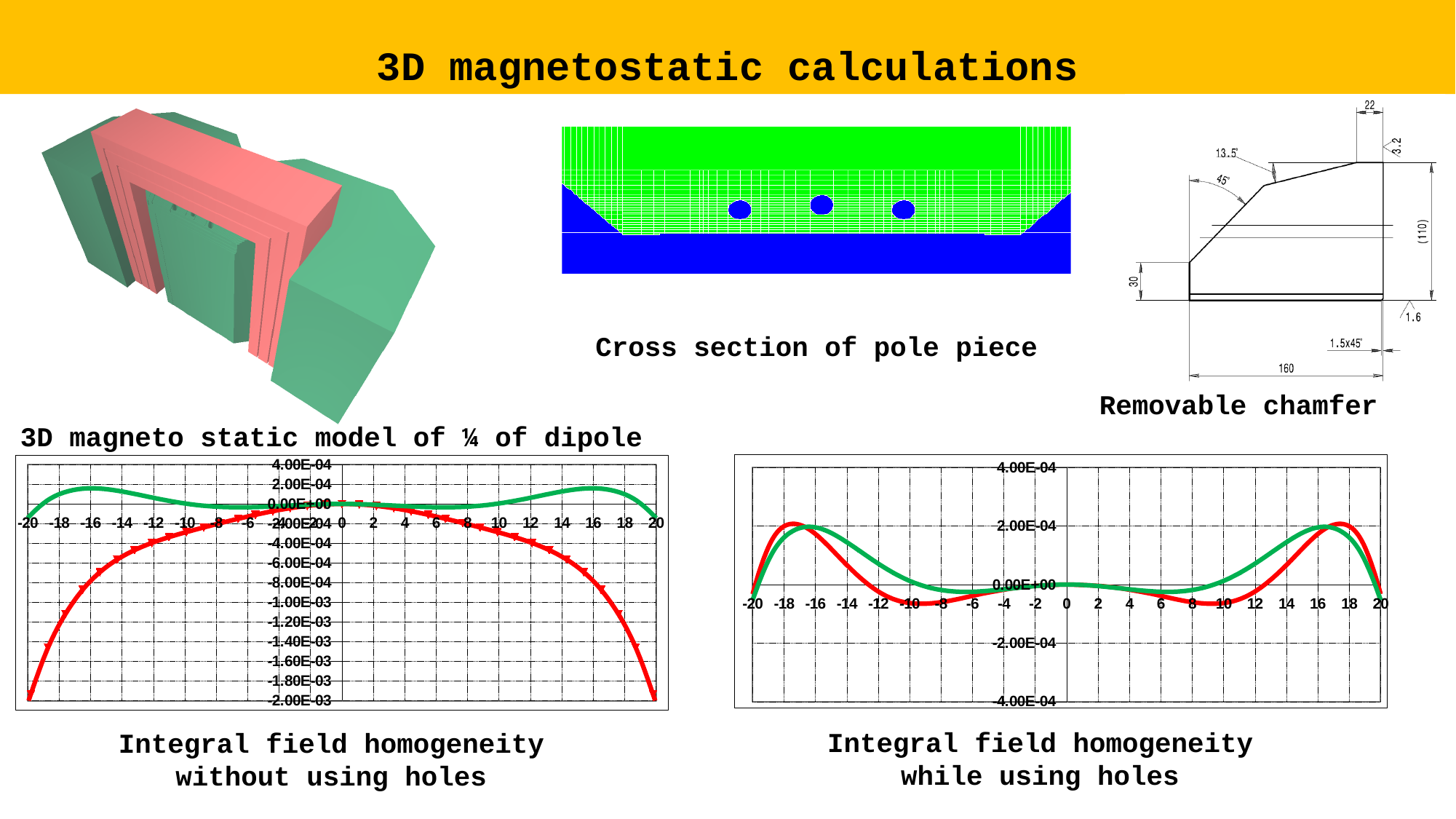
In the 'Integral field homogeneity while using holes' chart, is the value of the green line at x = 16 greater or less than 0.00E+00? greater In the 'Integral field homogeneity while using holes' chart, is the value of the red line at x = -10 greater or less than 0.00E+00? less In the 'Integral field homogeneity without using holes' chart, what is the lowest value labelled on the y axis? -2.00E-03 In the 'Integral field homogeneity without using holes' chart, how many lines are plotted? 2 What kind of chart is the 'Integral field homogeneity without using holes' chart? line chart In the 'Integral field homogeneity without using holes' chart, is the value of the red line at x = 20 greater or less than -1.00E-03? less In the 'Integral field homogeneity while using holes' chart, what are the lowest and highest values labelled on the y axis? -4.00E-04 and 4.00E-04 In the 'Integral field homogeneity without using holes' chart, does the red line rise or fall as x goes from 0 to 20? fall What kind of chart is the 'Integral field homogeneity while using holes' chart? line chart In the 'Integral field homogeneity without using holes' chart, how many tick labels are shown on the x axis from -20 to 20? 21 In the 'Integral field homogeneity while using holes' chart, how many lines are plotted? 2